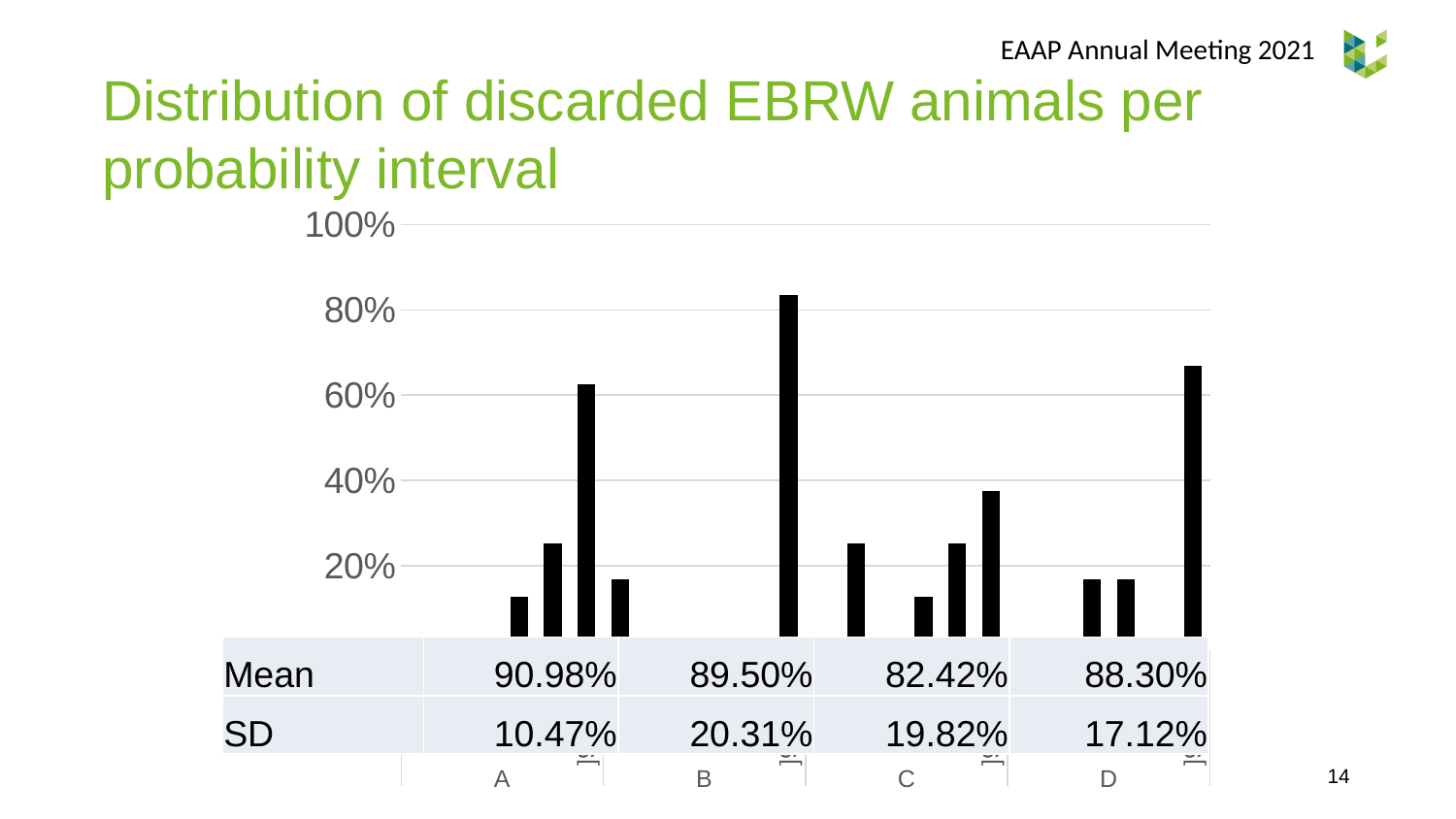
Is the tallest bar in group C greater or less than 40%? less How many bars are plotted in group B? 2 How many groups (A, B, C, D) are shown along the x axis of the chart? 4 What kind of chart is shown on the slide? bar chart Which group contains the tallest bar in the chart? B What is the Mean shown for group A? 90.98% Which group has the lowest Mean in the table? C What is the difference between the Mean for group A and the Mean for group C? 8.56% What is the SD shown for group B? 20.31% Is the tallest bar in group D greater or less than 60%? greater Is the tallest bar in group B greater or less than 80%? greater What is the title of the chart on the slide? Distribution of discarded EBRW animals per probability interval